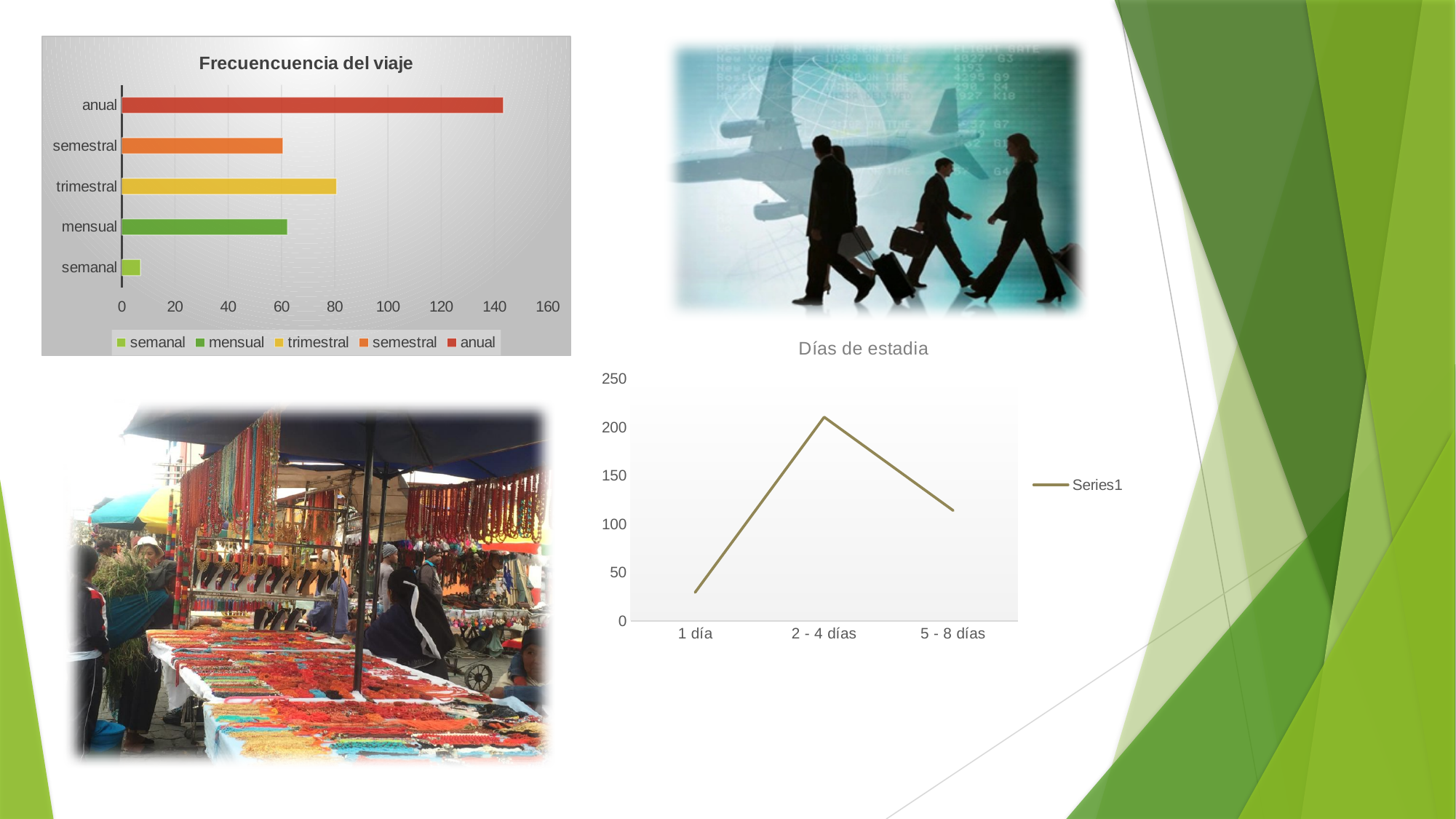
In the 'Días de estadia' chart, is the value for 1 día greater or less than 50? less In the 'Días de estadia' chart, what kind of chart is shown? line chart In the 'Frecuencuencia del viaje' chart, which category has the lowest value? semanal In the 'Frecuencuencia del viaje' chart, is the value for semanal greater or less than 20? less In the 'Frecuencuencia del viaje' chart, how many categories are plotted? 5 In the 'Frecuencuencia del viaje' chart, how many entries does the legend list? 5 In the 'Frecuencuencia del viaje' chart, which category has the highest value? anual In the 'Frecuencuencia del viaje' chart, is the value for anual greater or less than 120? greater In the 'Frecuencuencia del viaje' chart, which is larger, trimestral or semestral? trimestral In the 'Días de estadia' chart, which category has the highest value? 2 - 4 días In the 'Días de estadia' chart, what is the name of the series shown in the legend? Series1 In the 'Frecuencuencia del viaje' chart, what kind of chart is shown? bar chart